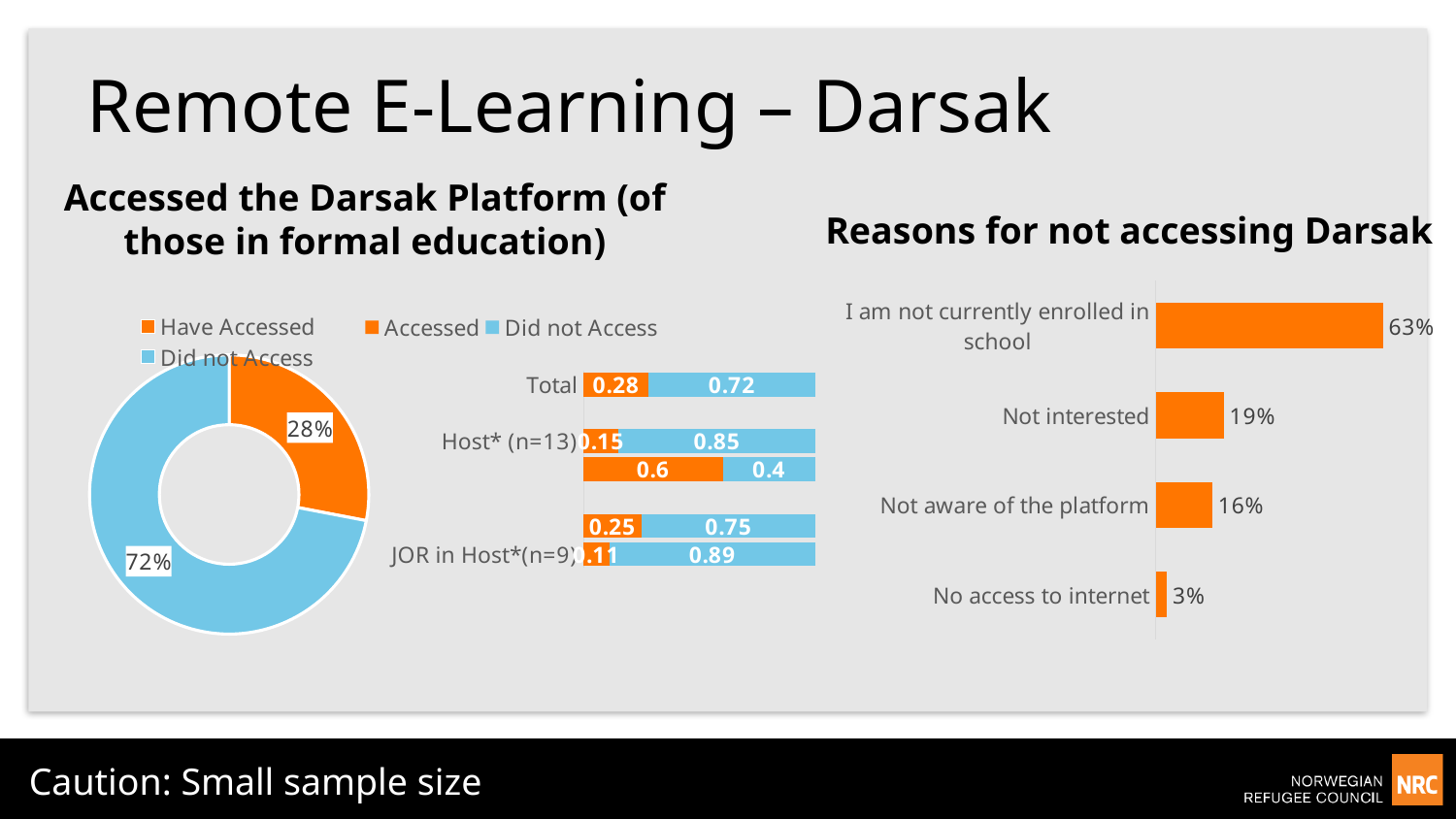
In the stacked bar chart in the middle, what is the 'Did not Access' value for 'Host* (n=13)'? 0.85 In the 'Reasons for not accessing Darsak' chart, what is the difference between 'I am not currently enrolled in school' and 'Not aware of the platform'? 47% In the 'Reasons for not accessing Darsak' chart, how many reasons are listed? 4 What kind of chart is the 'Reasons for not accessing Darsak' chart? Bar chart In the donut chart on the left, what share of respondents 'Have Accessed' the Darsak platform? 28% In the 'Reasons for not accessing Darsak' chart, which reason has the highest value? I am not currently enrolled in school In the donut chart on the left, which is larger: 'Have Accessed' or 'Did not Access'? Did not Access How many series does the legend of the stacked bar chart in the middle list? 2 In the 'Reasons for not accessing Darsak' chart, what is the value for 'Not interested'? 19% In the 'Reasons for not accessing Darsak' chart, which reason has the lowest value? No access to internet In the stacked bar chart in the middle, what is the 'Accessed' value for 'Total'? 0.28 In the stacked bar chart in the middle, what is the 'Did not Access' value for 'JOR in Host*(n=9)'? 0.89